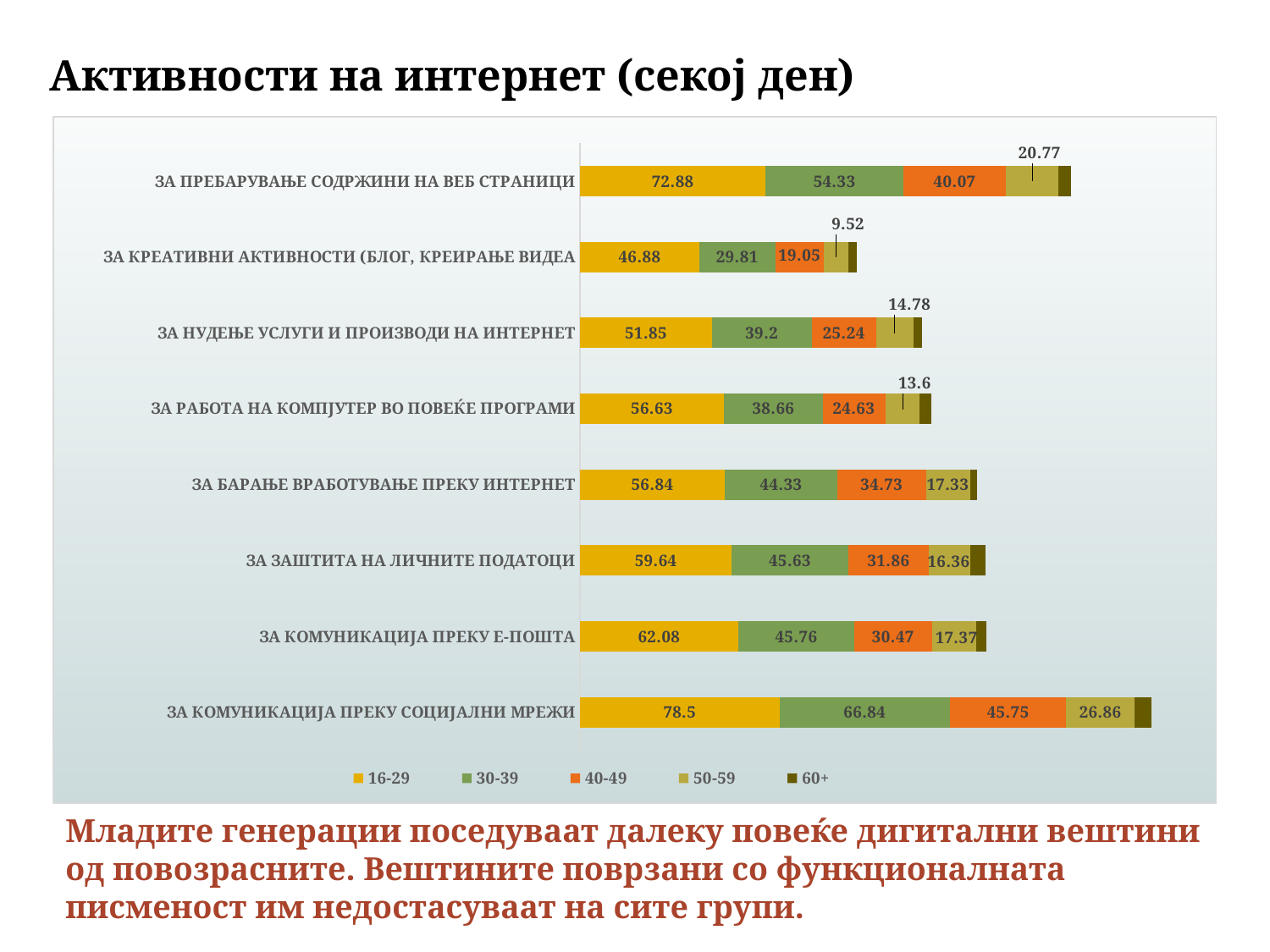
Which activity has the highest value for the 16-29 group? ЗА КОМУНИКАЦИЈА ПРЕКУ СОЦИЈАЛНИ МРЕЖИ What is the value for the 50-59 group for 'ЗА КРЕАТИВНИ АКТИВНОСТИ (БЛОГ, КРЕИРАЊЕ ВИДЕА'? 9.52 What is the value for the 16-29 group for 'ЗА КОМУНИКАЦИЈА ПРЕКУ СОЦИЈАЛНИ МРЕЖИ'? 78.5 What is the value for the 30-39 group for 'ЗА ПРЕБАРУВАЊЕ СОДРЖИНИ НА ВЕБ СТРАНИЦИ'? 54.33 What is the value for the 40-49 group for 'ЗА ЗАШТИТА НА ЛИЧНИТЕ ПОДАТОЦИ'? 31.86 How many age-group series does the legend list? 5 How many activity categories are plotted in the chart? 8 What is the title of the chart on the slide? Активности на интернет (секој ден) For 'ЗА БАРАЊЕ ВРАБОТУВАЊЕ ПРЕКУ ИНТЕРНЕТ', which group has the larger value: 30-39 or 40-49? 30-39 What type of chart is shown on the slide? stacked bar chart What is the difference between the 16-29 and 30-39 values for 'ЗА КОМУНИКАЦИЈА ПРЕКУ Е-ПОШТА'? 16.32 Which activity has the lowest value for the 16-29 group? ЗА КРЕАТИВНИ АКТИВНОСТИ (БЛОГ, КРЕИРАЊЕ ВИДЕА